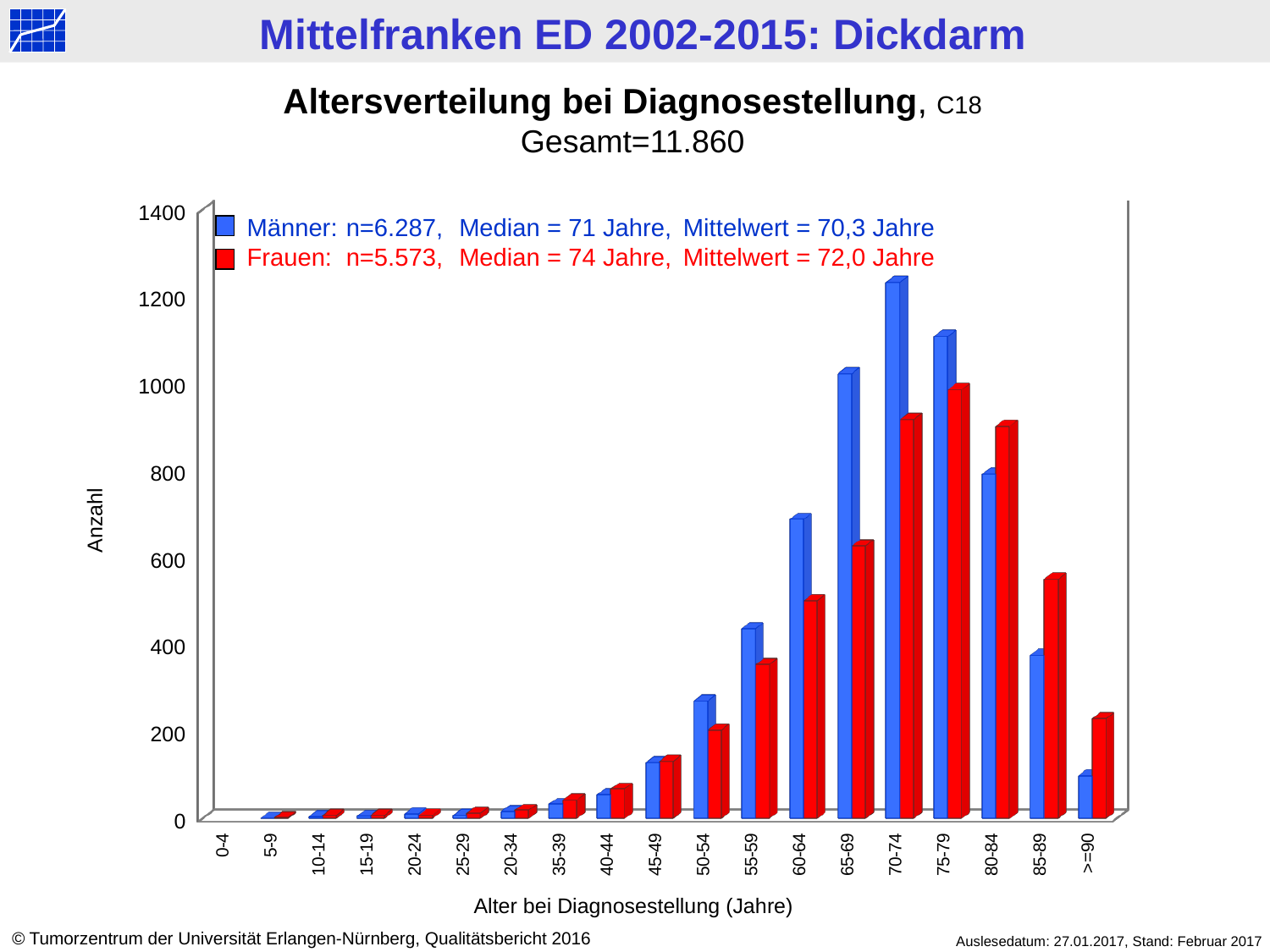
How many age-group categories are shown on the x axis? 19 In which age group is the Männer value highest? 70-74 According to the legend, what is the n for Männer? n=6.287 For the 60-64 age group, which series has the larger value, Männer or Frauen? Männer Is the Frauen value for the >=90 age group greater or less than 200? greater Is the Männer value for the 70-74 age group greater or less than 1200? greater What kind of chart is shown on the slide? bar chart In which age group is the Frauen value highest? 75-79 Is the Männer value for the 85-89 age group greater or less than 400? less For the 80-84 age group, which series has the larger value, Männer or Frauen? Frauen How many series does the legend list? 2